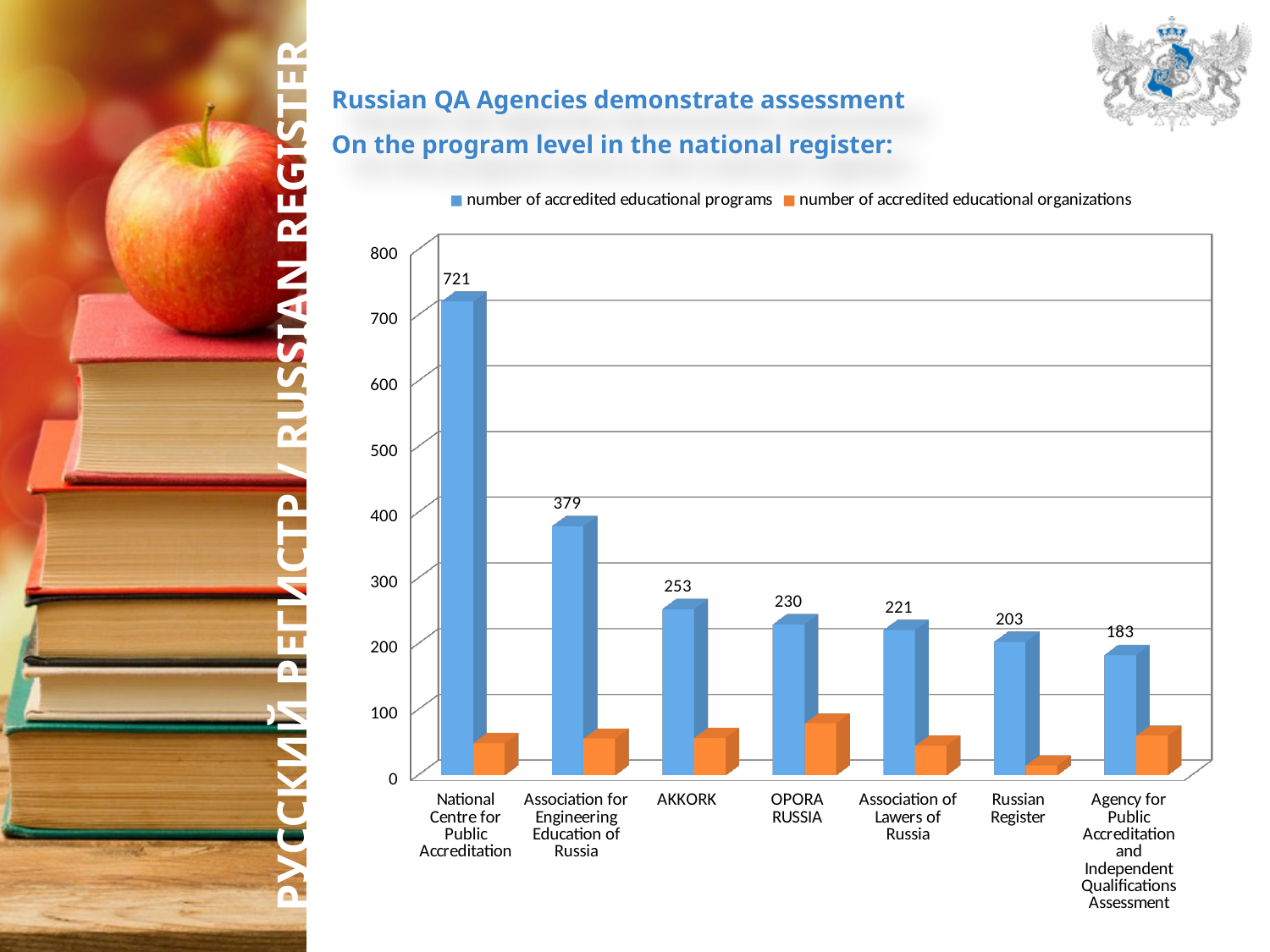
What is the difference in the number of accredited educational programs between the National Centre for Public Accreditation and the Association for Engineering Education of Russia? 342 How many agencies are shown on the x axis of the chart? 7 Which colour represents the number of accredited educational organizations in the chart? orange Which agency has the highest number of accredited educational programs? National Centre for Public Accreditation What is the number of accredited educational programs for AKKORK? 253 Which agency has the lowest number of accredited educational programs? Agency for Public Accreditation and Independent Qualifications Assessment Which has more accredited educational programs, OPORA RUSSIA or Russian Register? OPORA RUSSIA What kind of chart is shown on the slide? bar chart What is the number of accredited educational programs for the Agency for Public Accreditation and Independent Qualifications Assessment? 183 What is the number of accredited educational programs for the National Centre for Public Accreditation? 721 Is the number of accredited educational organizations for OPORA RUSSIA greater or less than 100? less How many series does the chart legend list? 2